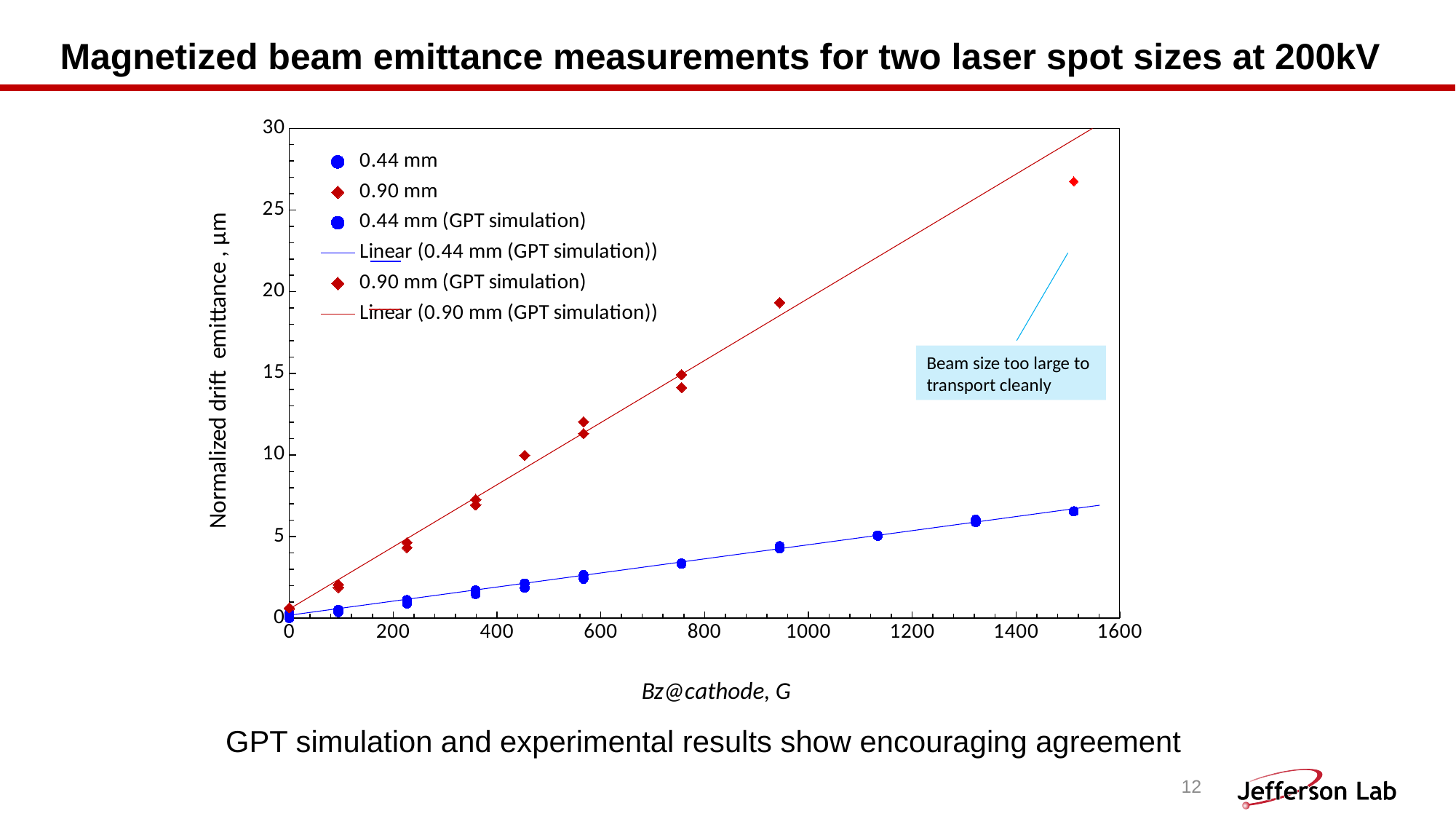
Is the 0.44 mm value at about 1500 G greater or less than 10? less Which laser spot size series reaches the highest normalized drift emittance? 0.90 mm What is the label of the y axis? Normalized drift emittance, μm Is the 0.90 mm value at about 1500 G greater or less than 25? greater What kind of chart is shown on the slide? scatter chart Is the 0.44 mm value at about 750 G greater or less than 5? less What does the callout box on the chart say? Beam size too large to transport cleanly How many series does the legend list? 6 At about 950 G, which series has the higher emittance, 0.44 mm or 0.90 mm? 0.90 mm Do the 0.90 mm emittance values rise or fall as Bz@cathode increases? rise